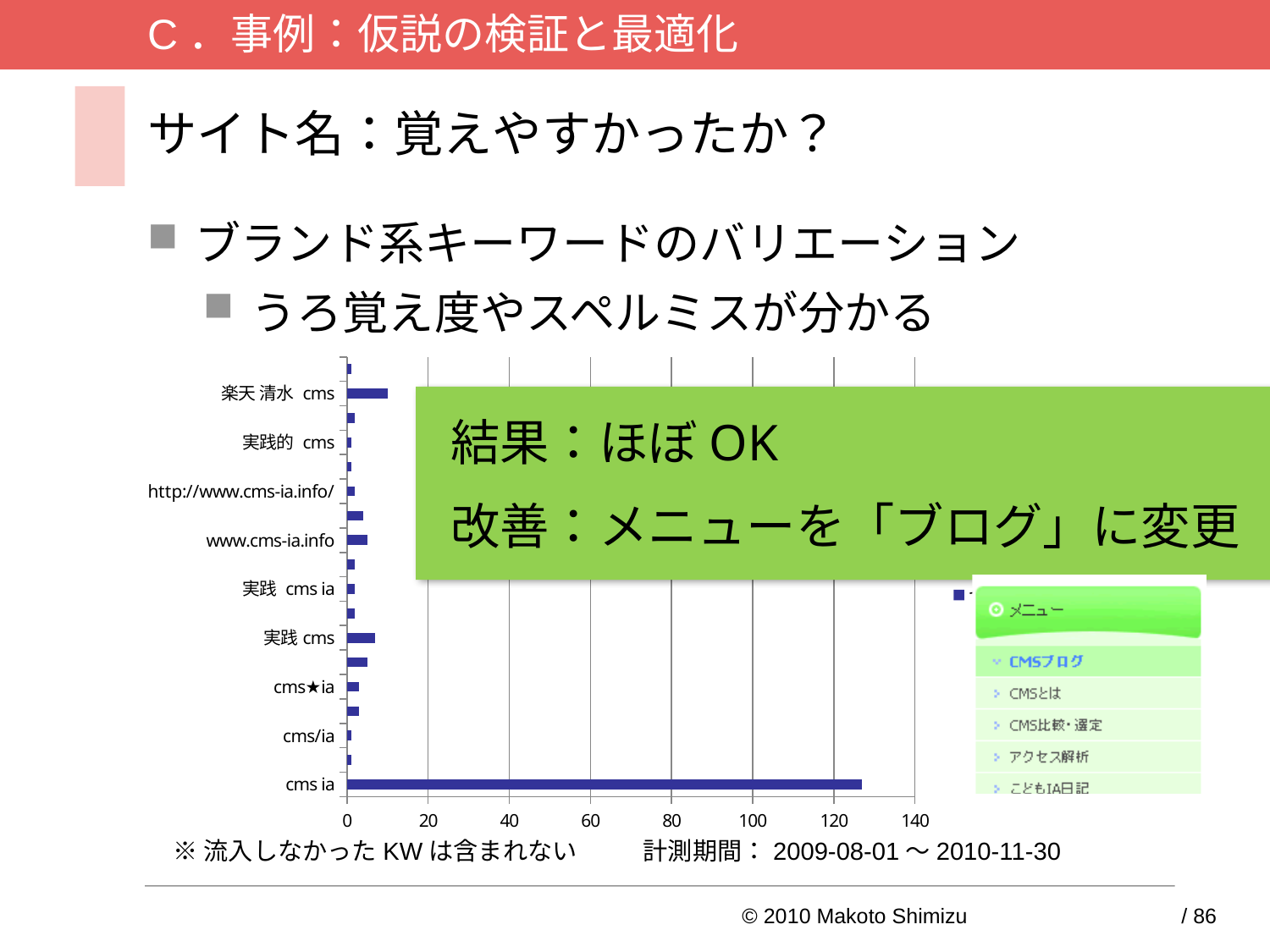
Is the value for cms ia greater or less than 120? greater Is the value for cms ia greater or less than 100? greater Which is larger, the value for cms ia or the value for 実践 cms? cms ia What is the interval between tick marks on the horizontal axis of the chart? 20 Is the value for www.cms-ia.info greater or less than 20? less What kind of chart is shown on the slide? bar chart Which category has the longest bar in the chart? cms ia What is the highest value shown on the horizontal axis of the chart? 140 Which is larger, the value for 楽天 清水 cms or the value for cms/ia? 楽天 清水 cms